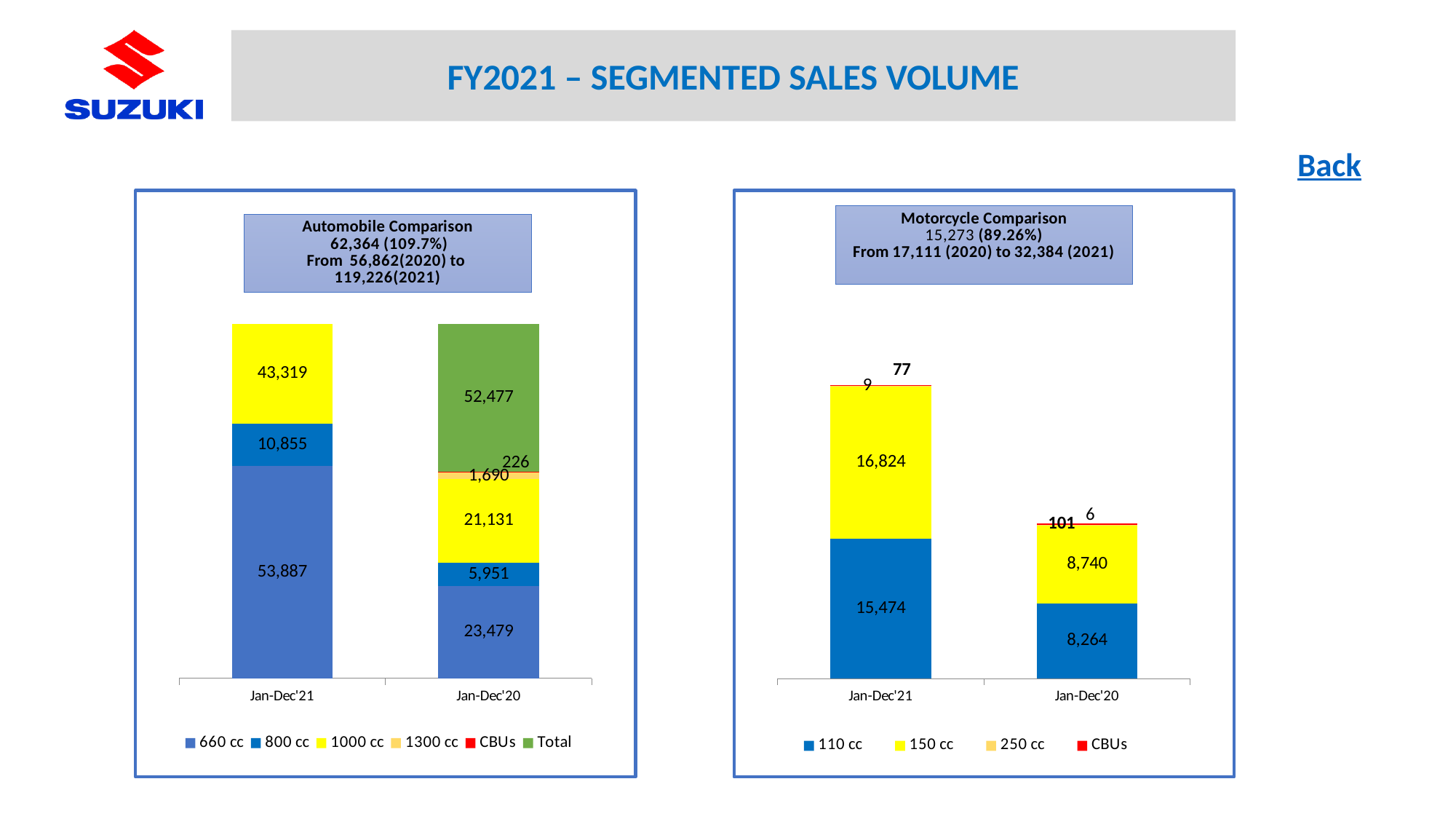
In the Automobile Comparison chart, what is the value for 800 cc in Jan-Dec'21? 10,855 In the Automobile Comparison chart, what is the value for 660 cc in Jan-Dec'21? 53,887 What kind of chart is the Automobile Comparison chart on the left? Stacked bar chart In the Motorcycle Comparison chart, what is the difference between the 110 cc values for Jan-Dec'21 and Jan-Dec'20? 7,210 In the Motorcycle Comparison chart, which is larger for Jan-Dec'21: 110 cc or 150 cc? 150 cc In the Motorcycle Comparison chart, what is the total of the Jan-Dec'21 stacked bar? 32,384 In the Automobile Comparison chart, what is the difference between the 660 cc values for Jan-Dec'21 and Jan-Dec'20? 30,408 In the Automobile Comparison chart, what is the value for 1000 cc in Jan-Dec'20? 21,131 How many series does the legend of the Automobile Comparison chart list? 6 In the Motorcycle Comparison chart, what is the value for 150 cc in Jan-Dec'21? 16,824 In the Motorcycle Comparison chart, what is the value for 110 cc in Jan-Dec'20? 8,264 How many series does the legend of the Motorcycle Comparison chart list? 4